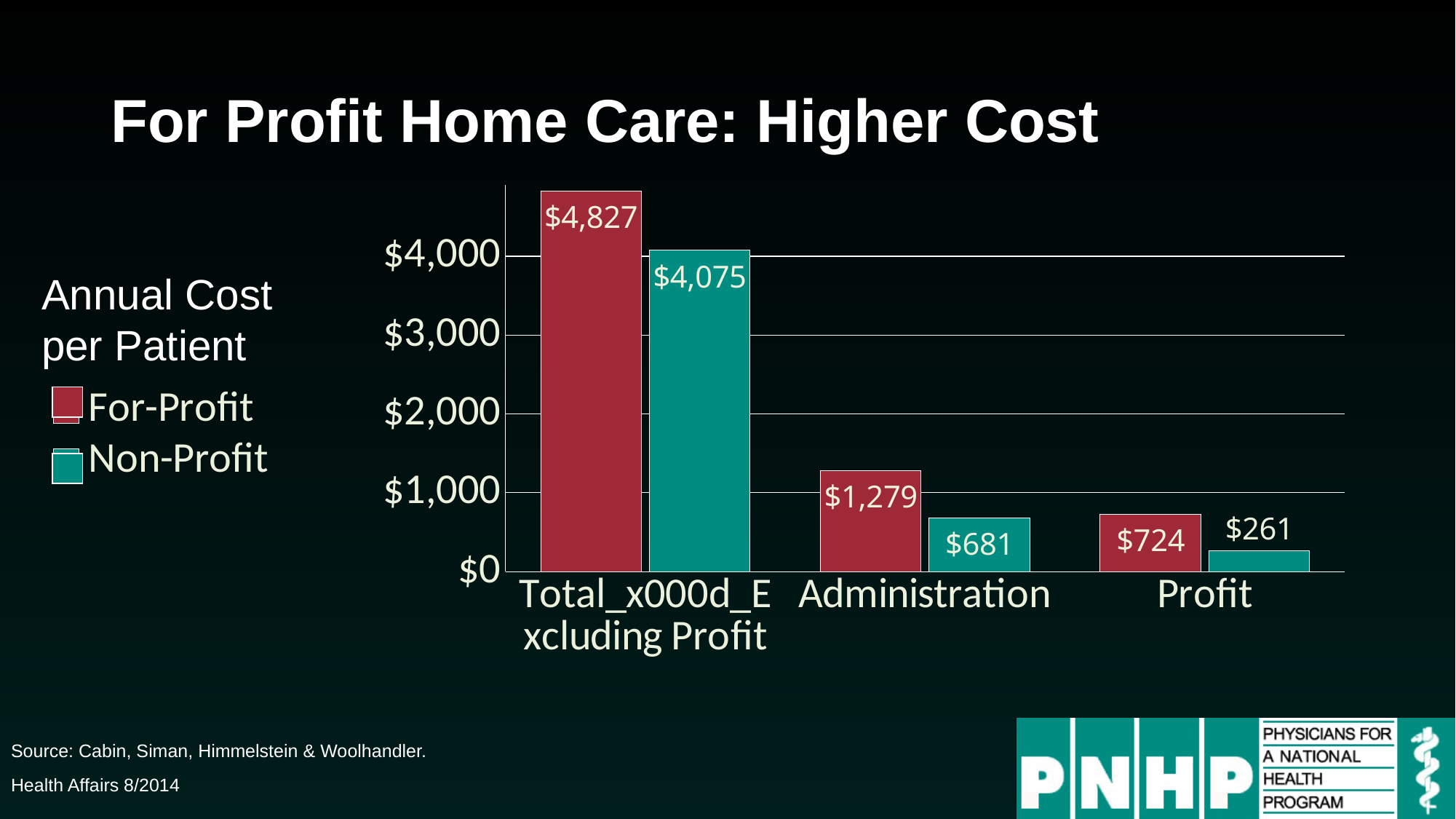
Which category has the highest For-Profit value? Total Excluding Profit What is the For-Profit annual cost per patient for Administration? $1,279 What is the difference between the For-Profit and Non-Profit values for Administration? $598 What is the For-Profit value for Profit? $724 How many categories are shown on the x axis? 3 Which is larger for Profit: the For-Profit value or the Non-Profit value? For-Profit What is the difference between the For-Profit and Non-Profit values for Total Excluding Profit? $752 What is the Non-Profit annual cost per patient for Profit? $261 Which category has the lowest Non-Profit value? Profit What is the Non-Profit value for the first category, Total Excluding Profit? $4,075 How many series does the legend list? 2 What kind of chart is shown on the slide? Bar chart